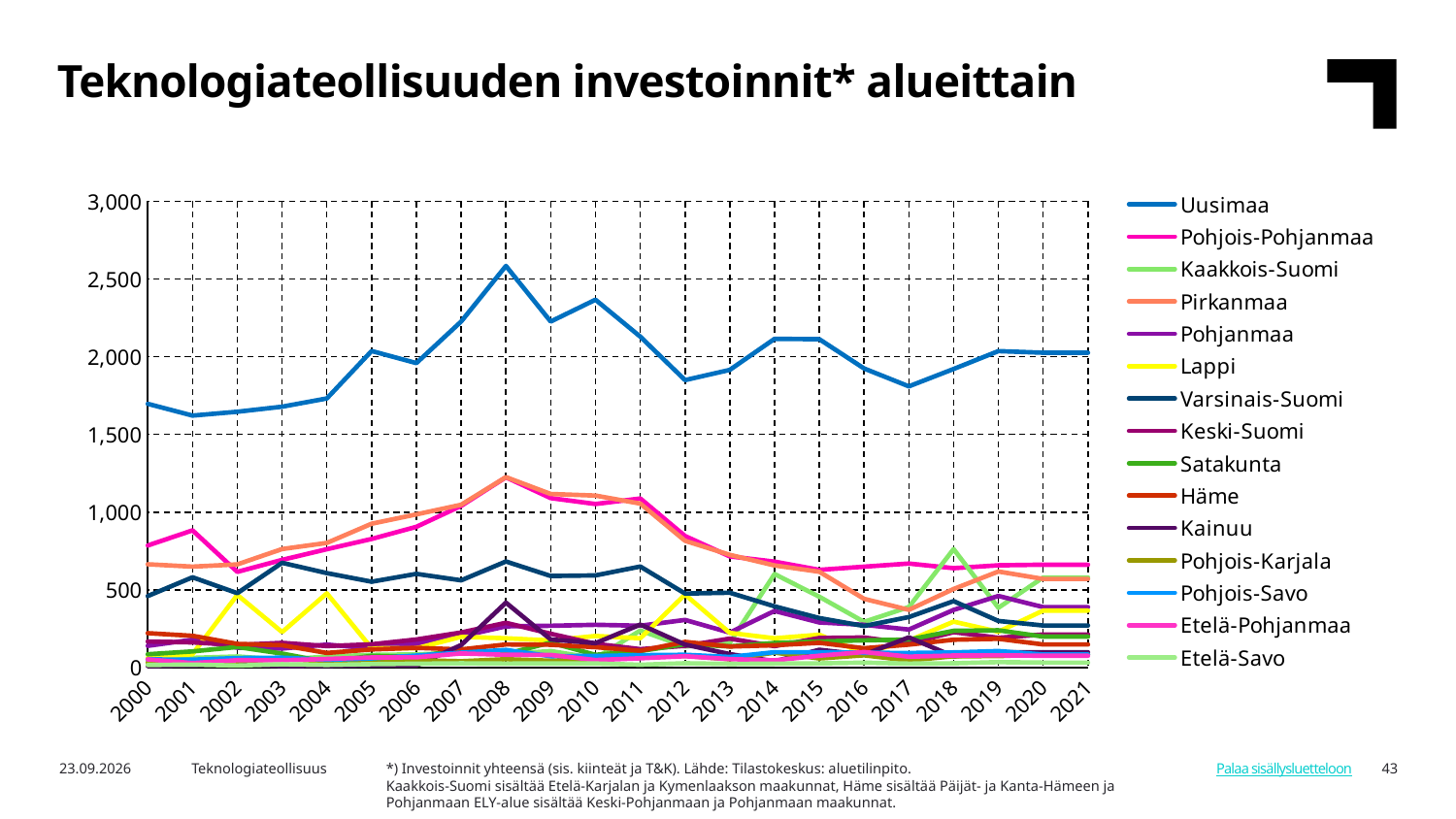
In which year does the Uusimaa line reach its peak? 2008 Is the value for Pirkanmaa in 2008 greater or less than 1,000? greater Which region has the highest investment values across the whole period? Uusimaa Does the Uusimaa line rise or fall between 2008 and 2012? fall What is the title of the chart on the slide? Teknologiateollisuuden investoinnit* alueittain Is the value for Uusimaa in 2017 greater or less than 2,000? less How many years are shown on the x axis? 22 Is the value for Pirkanmaa in 2017 greater or less than 500? less Which is larger in 2008, the value for Uusimaa or the value for Pirkanmaa? Uusimaa How many series does the legend list? 15 What kind of chart is shown on the slide? line chart